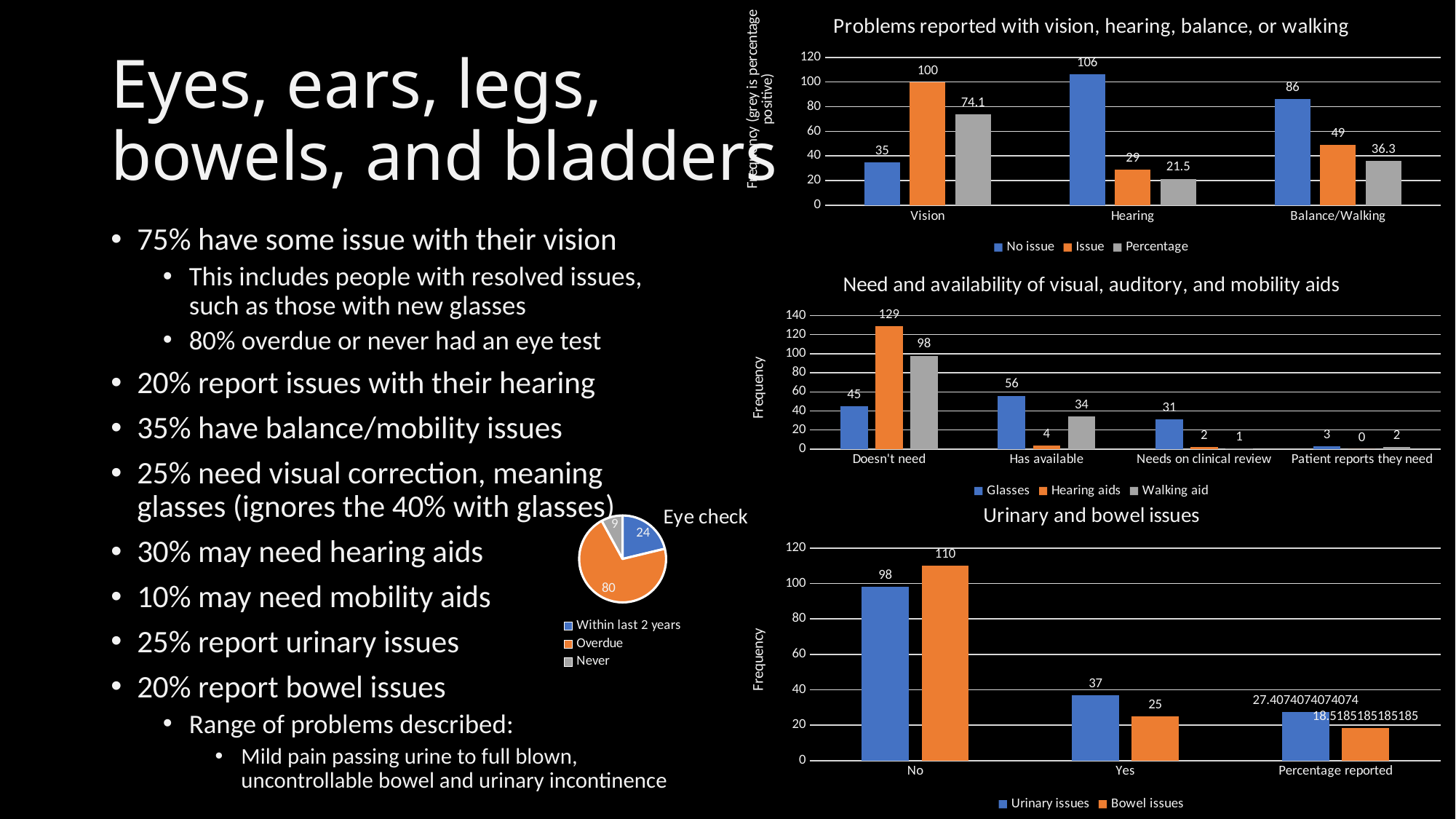
How many series does the legend of the 'Problems reported with vision, hearing, balance, or walking' chart list? 3 How many categories are shown on the x axis of the 'Need and availability of visual, auditory, and mobility aids' chart? 4 In the 'Problems reported with vision, hearing, balance, or walking' chart, what is the difference between the No issue and Issue values for Balance/Walking? 37 In the 'Need and availability of visual, auditory, and mobility aids' chart, what is the Hearing aids value for Doesn't need? 129 In the 'Problems reported with vision, hearing, balance, or walking' chart, what is the No issue value for Hearing? 106 In the 'Urinary and bowel issues' chart, what is the Bowel issues value for No? 110 In the 'Urinary and bowel issues' chart, which series has the larger value for Yes, Urinary issues or Bowel issues? Urinary issues In the 'Problems reported with vision, hearing, balance, or walking' chart, what is the value of the Issue series for Vision? 100 In the 'Eye check' pie chart, what is the value of the Overdue slice? 80 What kind of chart is the 'Eye check' chart? Pie chart In the 'Need and availability of visual, auditory, and mobility aids' chart, which category has the highest Glasses value? Has available In the 'Urinary and bowel issues' chart, what is the Urinary issues value for Percentage reported? 27.4074074074074